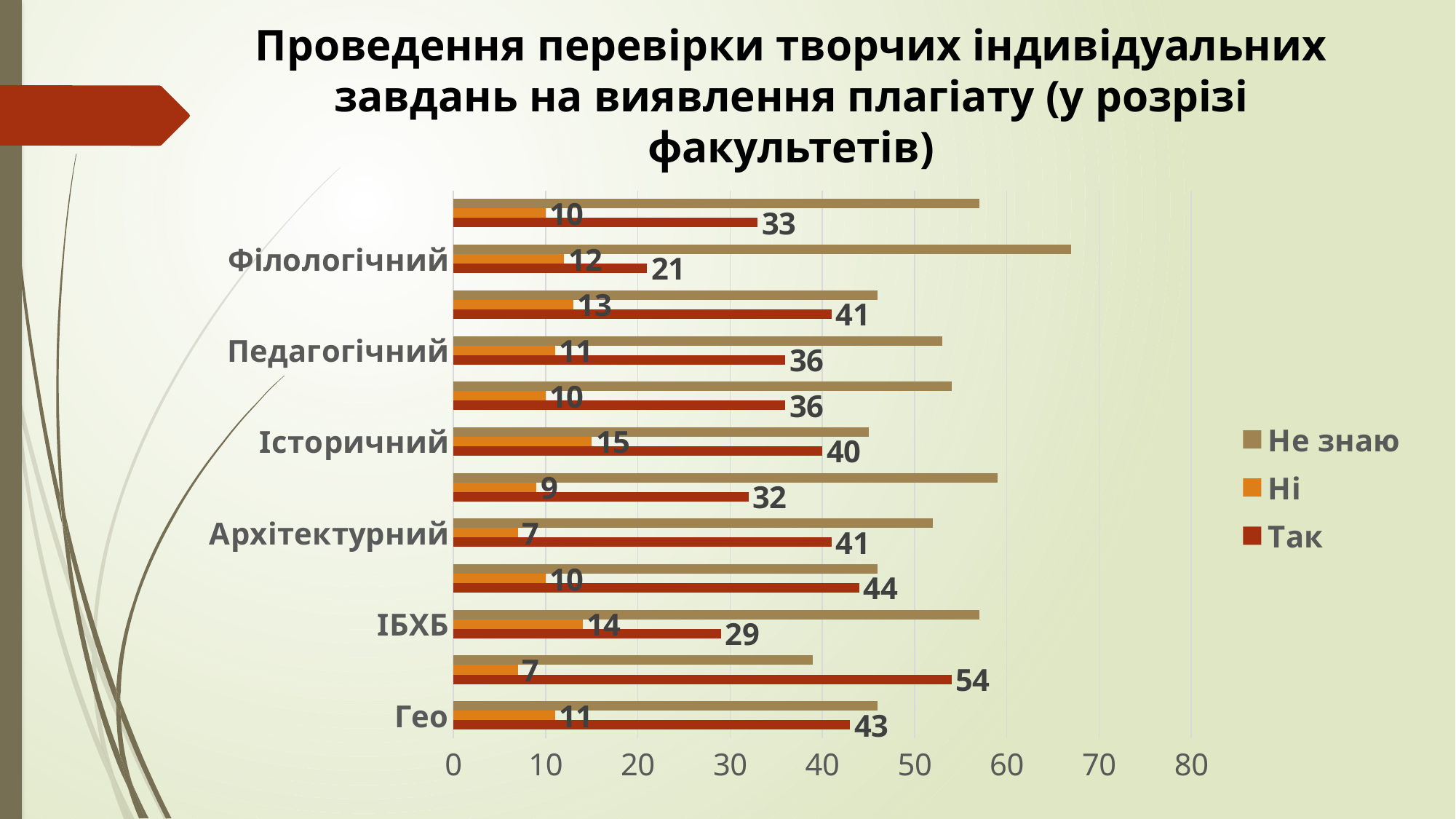
What is the value of the "Так" series for ІБХБ? 29 What is the difference between the "Так" and "Ні" values for Гео? 32 What is the value of the "Так" series for Гео? 43 How many series does the legend list? 3 Is the "Не знаю" value for Філологічний greater or less than 60? greater What is the value of the "Так" series for Філологічний? 21 What is the value of the "Ні" series for Історичний? 15 What kind of chart is shown on the slide? bar chart What is the value of the "Ні" series for Архітектурний? 7 Among the labelled faculties, which has the lowest "Ні" value? Архітектурний Among the labelled faculties, which has the highest "Ні" value? Історичний Which is larger for Педагогічний: the "Так" value or the "Ні" value? Так